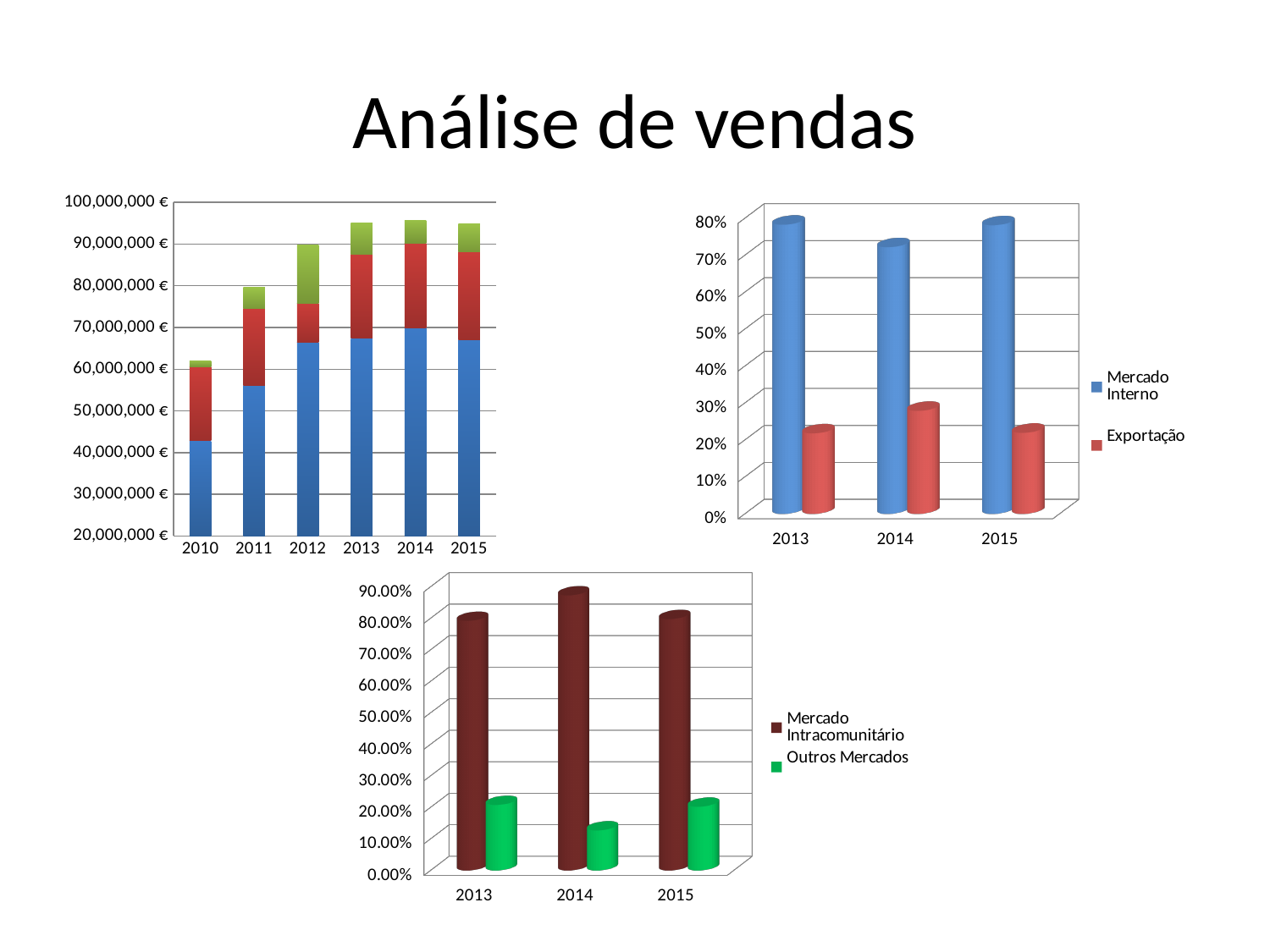
How many years are shown on the x axis of the top-left chart? 6 In the top-right chart, which year has the lowest value for Mercado Interno? 2014 In the top-left chart, does the total bar height rise or fall from 2010 to 2013? rise In the bottom chart, is the value for Outros Mercados in 2014 greater or less than 20.00%? less In the top-right chart, is the value for Exportação in 2014 greater or less than 20%? greater How many series does the legend of the top-right chart list? 2 In the top-right chart, which year has the highest value for Exportação? 2014 What are the two series listed in the legend of the bottom chart? Mercado Intracomunitário and Outros Mercados In the bottom chart, which year has the highest value for Mercado Intracomunitário? 2014 In the top-left chart, is the total for 2011 greater or less than 70,000,000 €? greater In the top-left chart, which year has the lowest total bar? 2010 What kind of chart is the top-left chart on the slide? stacked bar chart